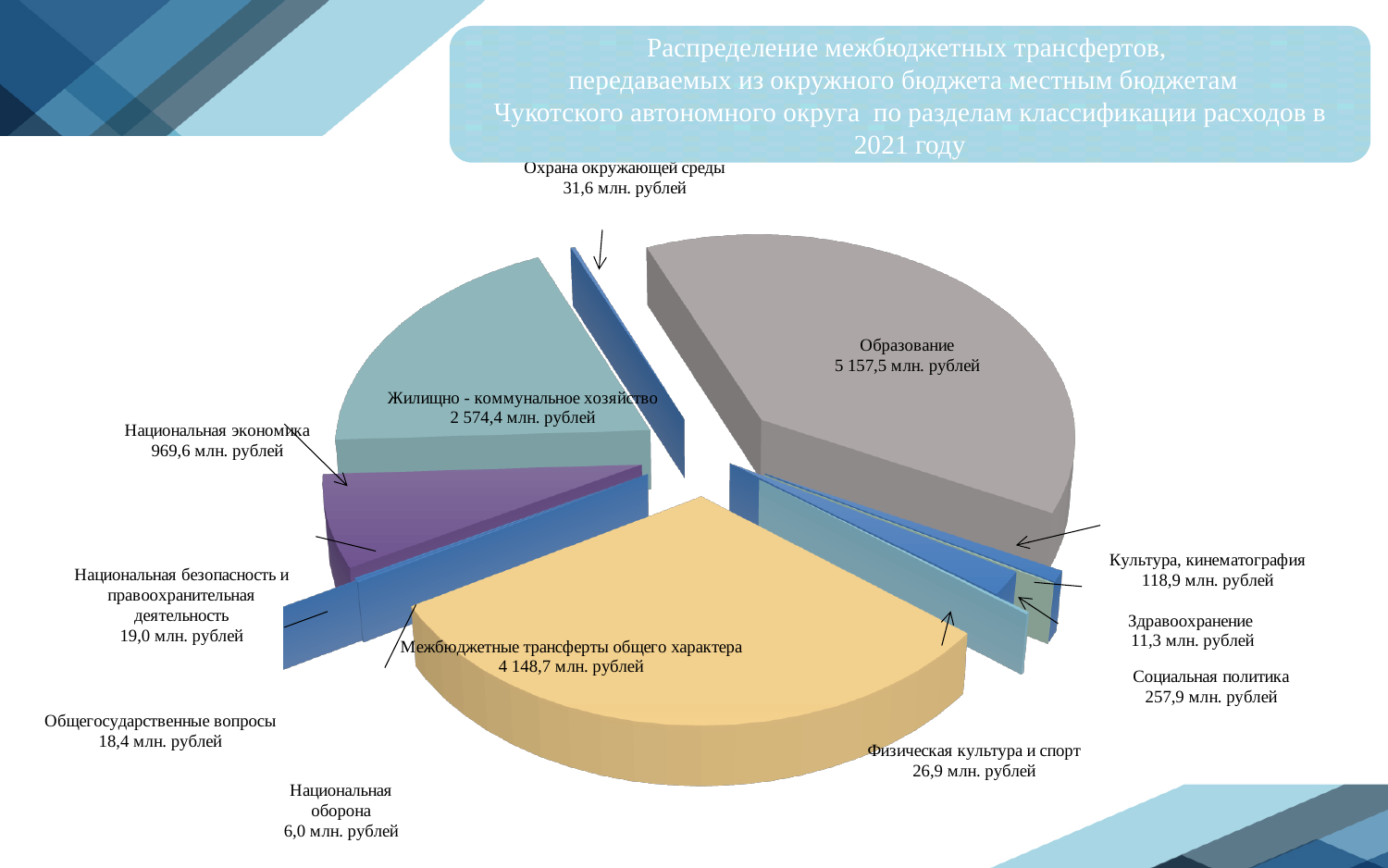
What is the value for Культура, кинематография? 118,9 млн. рублей Which category has the smallest value? Национальная оборона What type of chart is shown on the slide? pie chart How many categories are shown in the pie chart? 12 Which is larger, Здравоохранение or Физическая культура и спорт? Физическая культура и спорт Which category has the largest value? Образование What is the value for Жилищно - коммунальное хозяйство? 2 574,4 млн. рублей What is the difference between Образование and Межбюджетные трансферты общего характера? 1 008,8 млн. рублей What is the value for Образование? 5 157,5 млн. рублей What is the value for Социальная политика? 257,9 млн. рублей What is the difference between Жилищно - коммунальное хозяйство and Национальная экономика? 1 604,8 млн. рублей What is the value for Национальная оборона? 6,0 млн. рублей